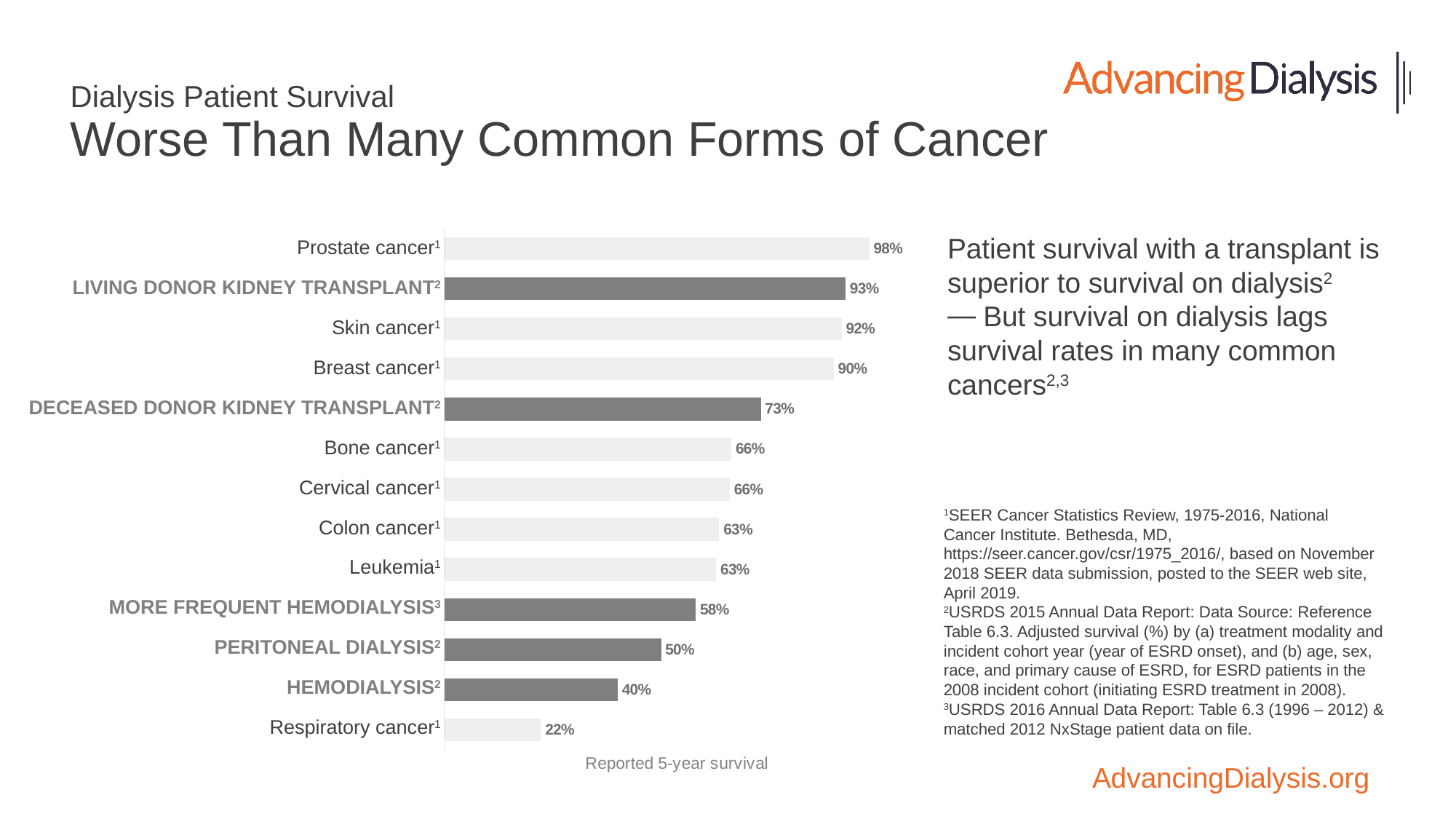
What is the reported 5-year survival for Living Donor Kidney Transplant? 93% Which category has the highest reported 5-year survival? Prostate cancer Which has a higher reported 5-year survival, Peritoneal Dialysis or Hemodialysis? Peritoneal Dialysis Which has a higher reported 5-year survival, More Frequent Hemodialysis or Colon cancer? Colon cancer What is the label shown beneath the chart's bars? Reported 5-year survival What is the difference in reported 5-year survival between Living Donor Kidney Transplant and Deceased Donor Kidney Transplant? 20% What is the reported 5-year survival for Prostate cancer? 98% What kind of chart is shown on the slide? Bar chart How many categories are shown in the chart? 13 Which category has the lowest reported 5-year survival? Respiratory cancer What is the difference in reported 5-year survival between Skin cancer and Respiratory cancer? 70% What is the reported 5-year survival for Hemodialysis? 40%